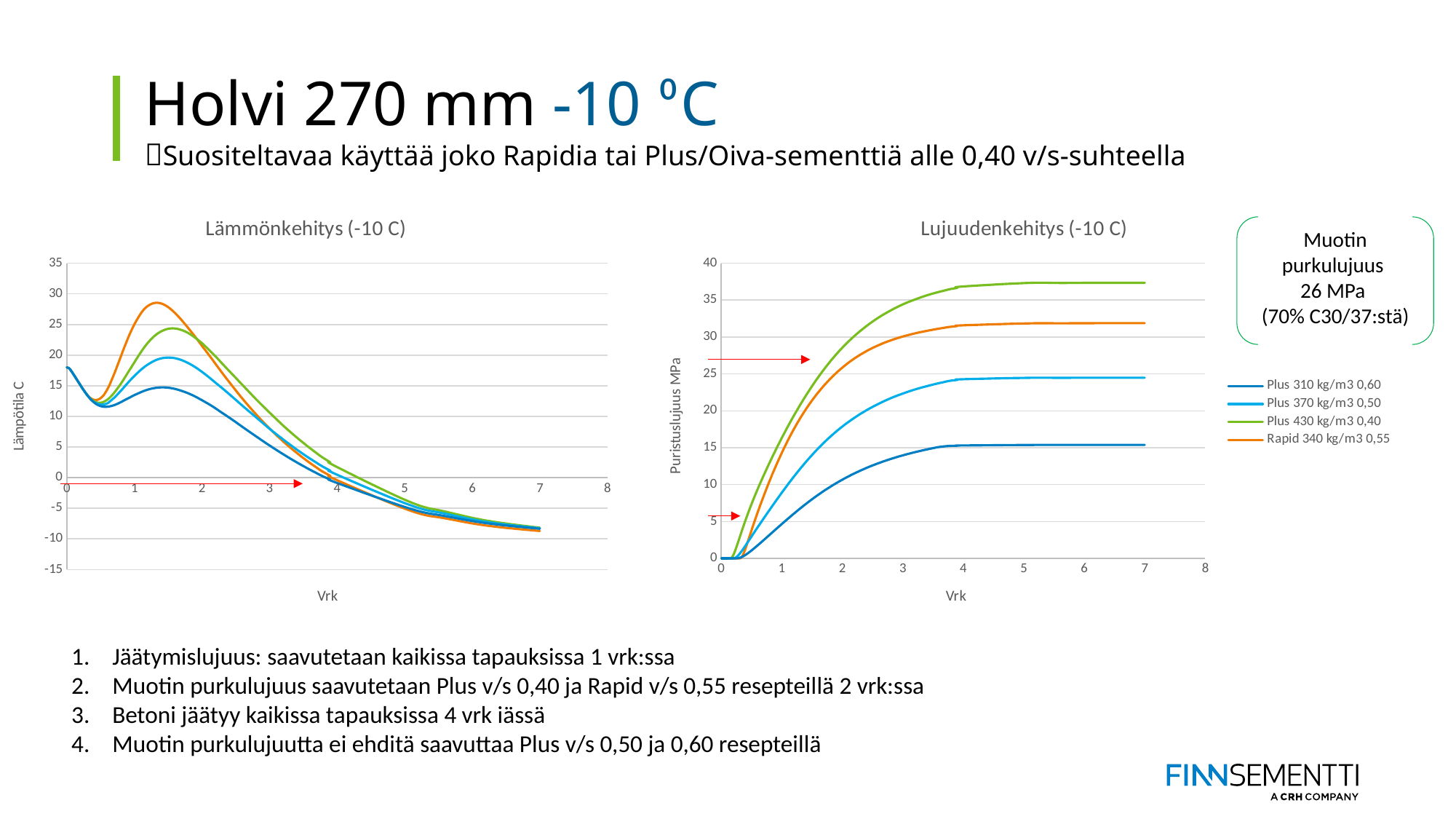
What is the y-axis label of the Lujuudenkehitys (-10 C) chart? Puristuslujuus MPa How many series does the legend list for the charts? 4 In the Lujuudenkehitys (-10 C) chart, is the value for Rapid 340 kg/m3 0,55 at 7 vrk greater or less than 30? greater In the Lujuudenkehitys (-10 C) chart, is the value for Plus 430 kg/m3 0,40 at 7 vrk greater or less than 35? greater In the Lujuudenkehitys (-10 C) chart, which series reaches the lowest strength? Plus 310 kg/m3 0,60 In the Lämmönkehitys (-10 C) chart, is the peak value for Rapid 340 kg/m3 0,55 greater or less than 25? greater What kind of chart is the Lämmönkehitys (-10 C) chart? line chart In the Lämmönkehitys (-10 C) chart, which series reaches the highest peak temperature? Rapid 340 kg/m3 0,55 In the Lujuudenkehitys (-10 C) chart, which series reaches the highest strength? Plus 430 kg/m3 0,40 In the Lämmönkehitys (-10 C) chart, do the temperatures rise or fall between 2 vrk and 7 vrk? fall What kind of chart is the Lujuudenkehitys (-10 C) chart? line chart